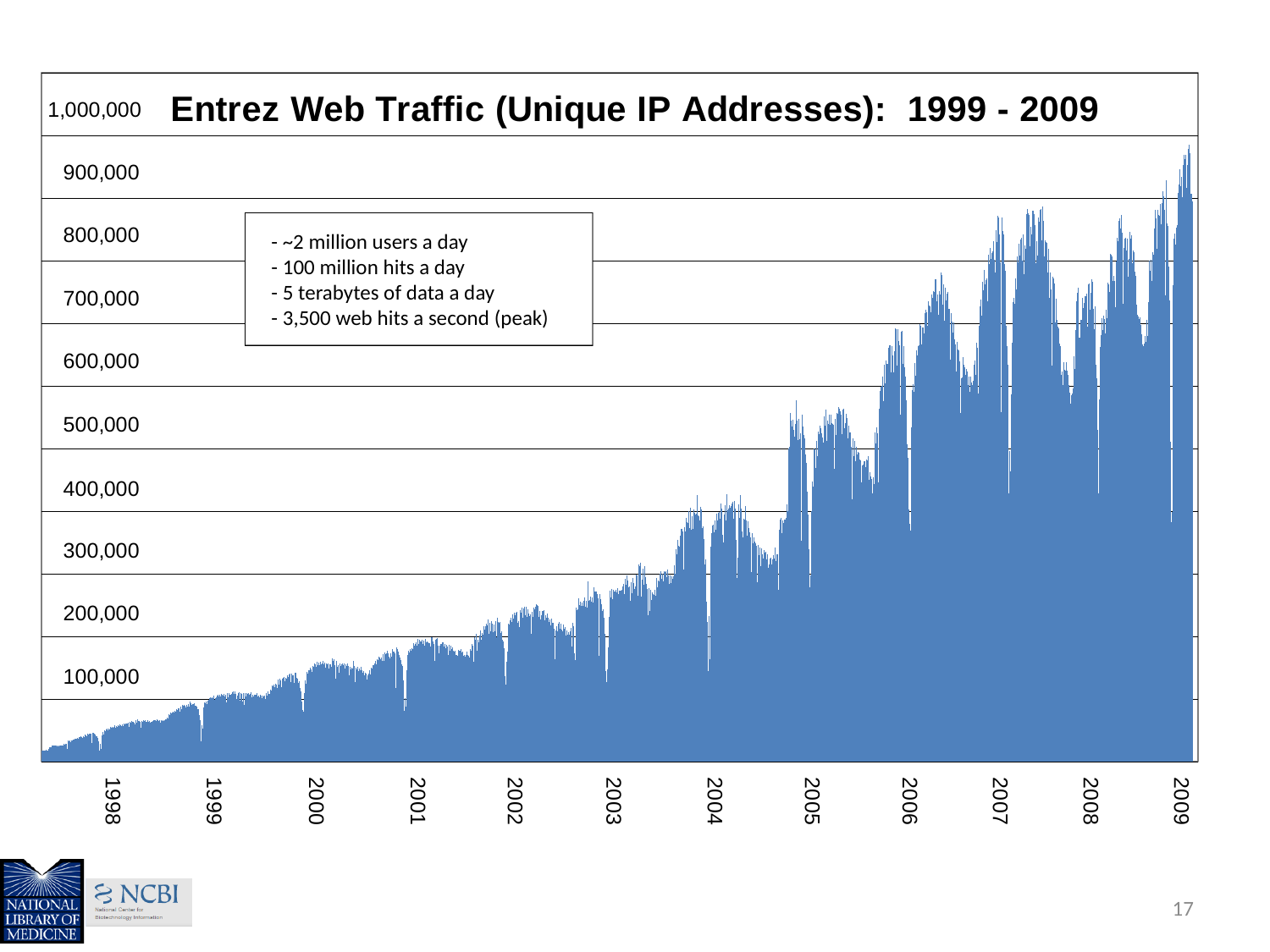
How many year labels are shown on the x axis? 12 Is the value at the start of 2001 greater or less than 200,000? less In which year does the chart reach its highest values? 2009 In which year are the chart's values lowest? 1998 What kind of chart is shown on the slide? area chart What is the title of the chart? Entrez Web Traffic (Unique IP Addresses): 1999 - 2009 Do the values generally rise or fall from 1998 to 2009? rise Which year has higher traffic values, 2000 or 2006? 2006 Is the peak value in 2009 greater or less than 800,000? greater What is the highest value labelled on the y axis? 1,000,000